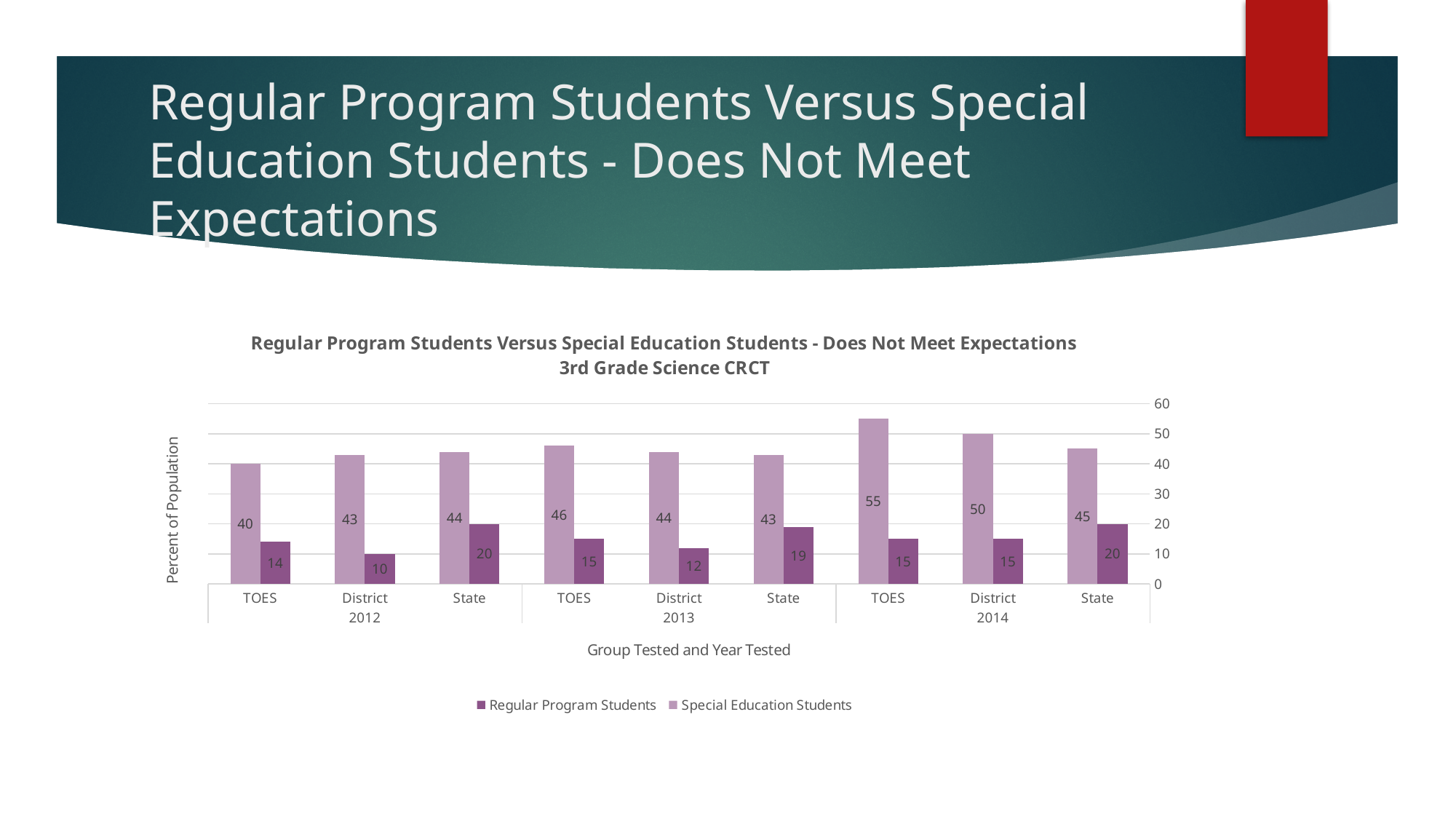
What is the label of the y axis? Percent of Population Which group and year has the highest value for Special Education Students? TOES 2014 What is the value for Regular Program Students at District in 2012? 10 What is the value for Special Education Students at TOES in 2014? 55 How many bars are plotted for Regular Program Students? 9 How many series does the legend list? 2 Which group and year has the lowest value for Regular Program Students? District 2012 What is the value for Regular Program Students at State in 2013? 19 What is the difference between Special Education Students and Regular Program Students at TOES in 2014? 40 Does the Special Education Students value at TOES rise or fall from 2012 to 2014? Rise What kind of chart is shown on the slide? Bar chart Which is larger: the Special Education Students value at District in 2014 or at State in 2014? District 2014